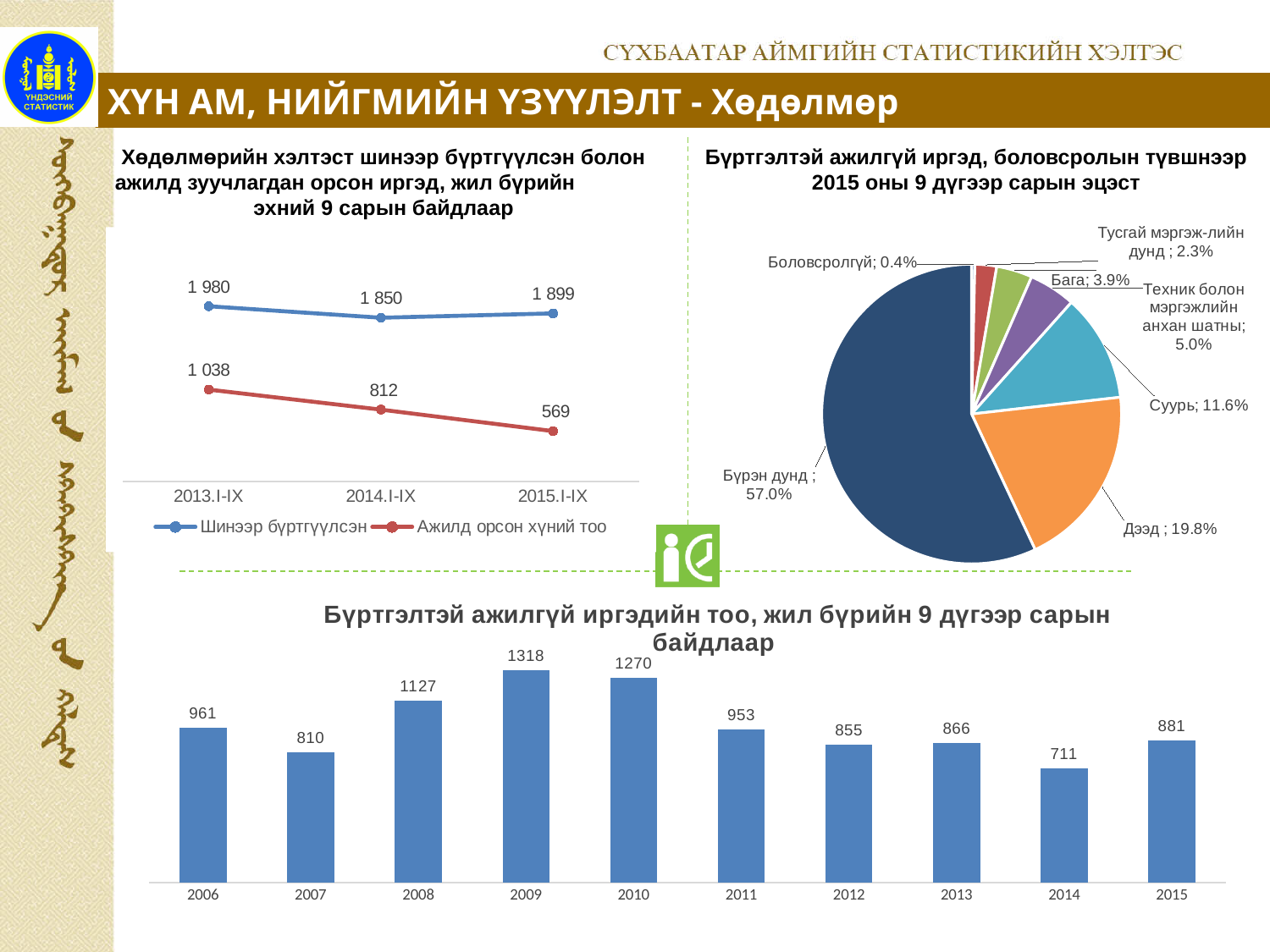
In the bottom bar chart, how many years are shown on the x axis? 10 In the bottom bar chart, what is the value for 2009? 1318 In the top-left line chart, what is the value of Шинээр бүртгүүлсэн for 2013.I-IX? 1 980 In the top-left line chart, what is the value of Ажилд орсон хүний тоо for 2015.I-IX? 569 In the top-right pie chart, what share does Дээд have? 19.8% In the bottom bar chart, which year has the lowest value? 2014 In the top-right pie chart, which category has the largest slice? Бүрэн дунд In the bottom bar chart, is the value for 2012 larger or smaller than the value for 2013? smaller In the bottom bar chart, which year has the highest value? 2009 In the top-left line chart, how many series does the legend list? 2 In the bottom bar chart, what is the difference between the values for 2010 and 2011? 317 In the top-left line chart, does the Ажилд орсон хүний тоо series rise or fall from 2013.I-IX to 2015.I-IX? fall